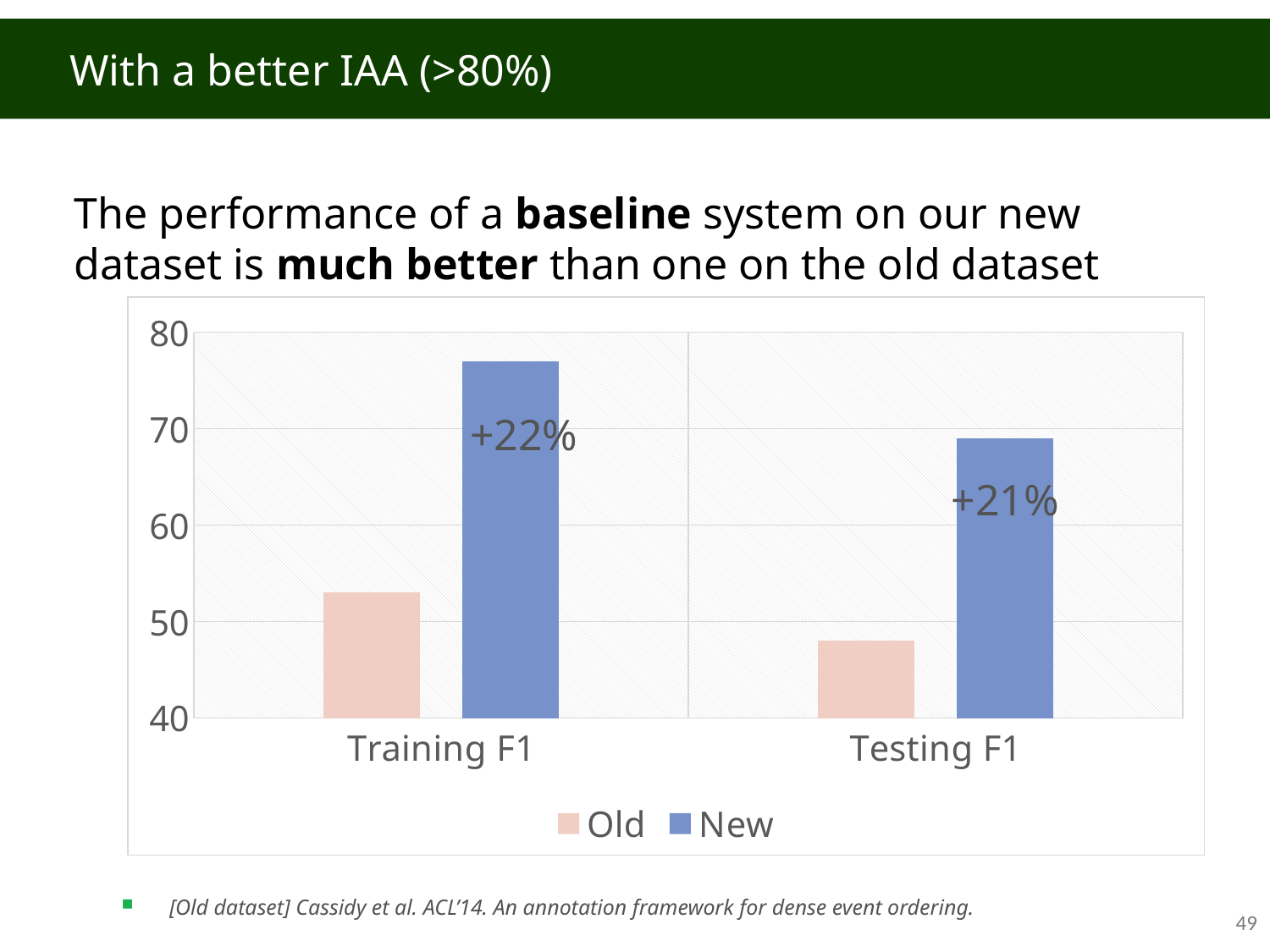
What improvement label is printed next to the New bar for Testing F1? +21% What kind of chart is shown on the slide? bar chart Is the Old value for Testing F1 greater or less than 50? less What are the two series named in the chart's legend? Old and New Which bar is the lowest in the chart? Old, Testing F1 What improvement label is printed next to the New bar for Training F1? +22% Is the New value for Testing F1 greater or less than 60? greater How many series does the chart's legend list? 2 Which bar is the highest in the chart? New, Training F1 Is the New value for Training F1 greater or less than 70? greater How many categories are shown on the x axis of the chart? 2 For Training F1, which series has the larger value, Old or New? New